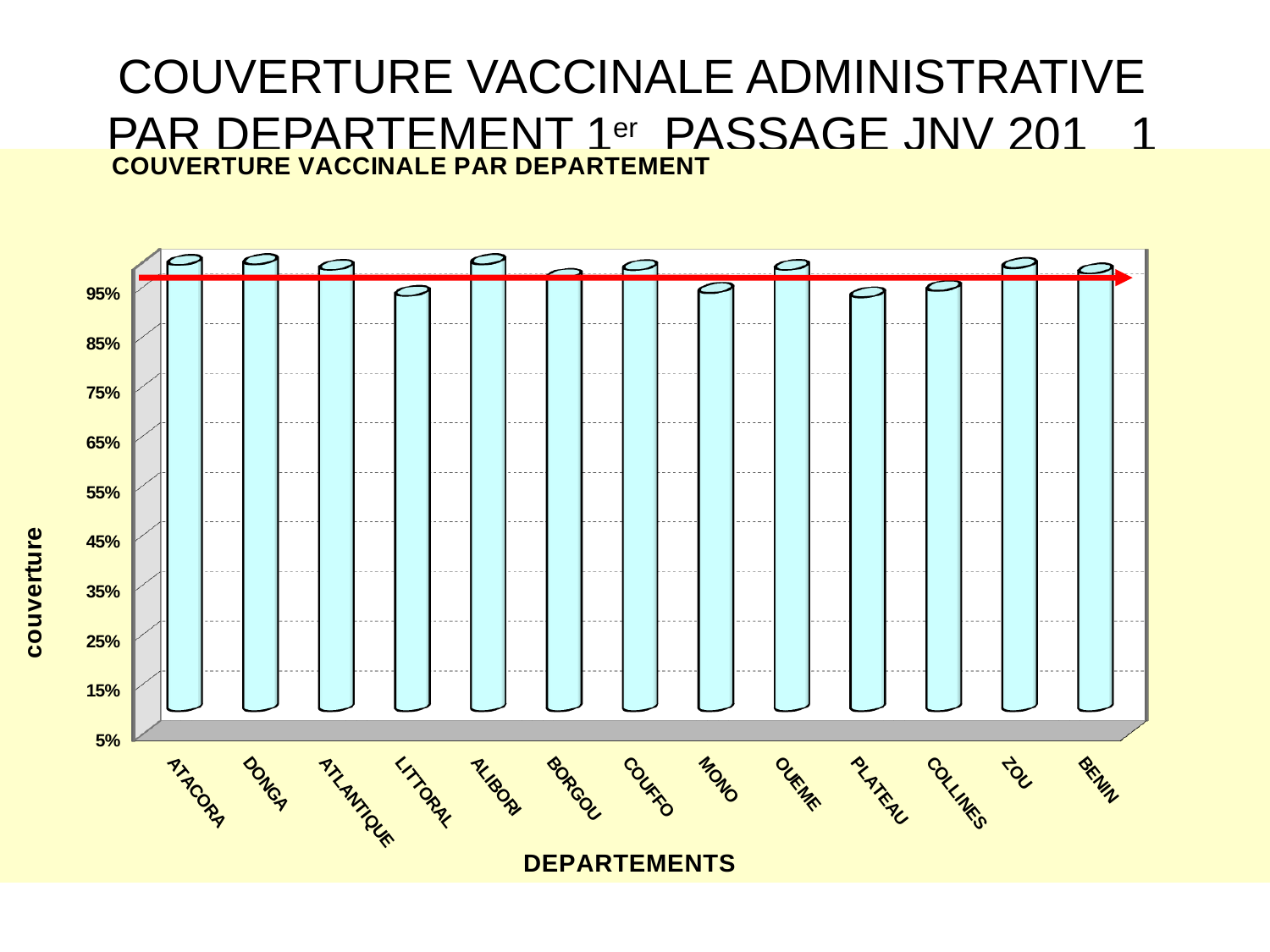
What kind of chart is shown on the slide? bar chart Is the value for ATACORA greater or less than 95%? greater Which has the larger value, ALIBORI or LITTORAL? ALIBORI Which has the larger value, DONGA or PLATEAU? DONGA Which has the larger value, ZOU or MONO? ZOU Is the value for PLATEAU greater or less than 85%? greater What is the title printed above the chart? COUVERTURE VACCINALE PAR DEPARTEMENT How many departments are plotted on the x axis of the chart? 13 What is the label of the vertical axis of the chart? couverture Is the value for LITTORAL greater or less than 85%? greater